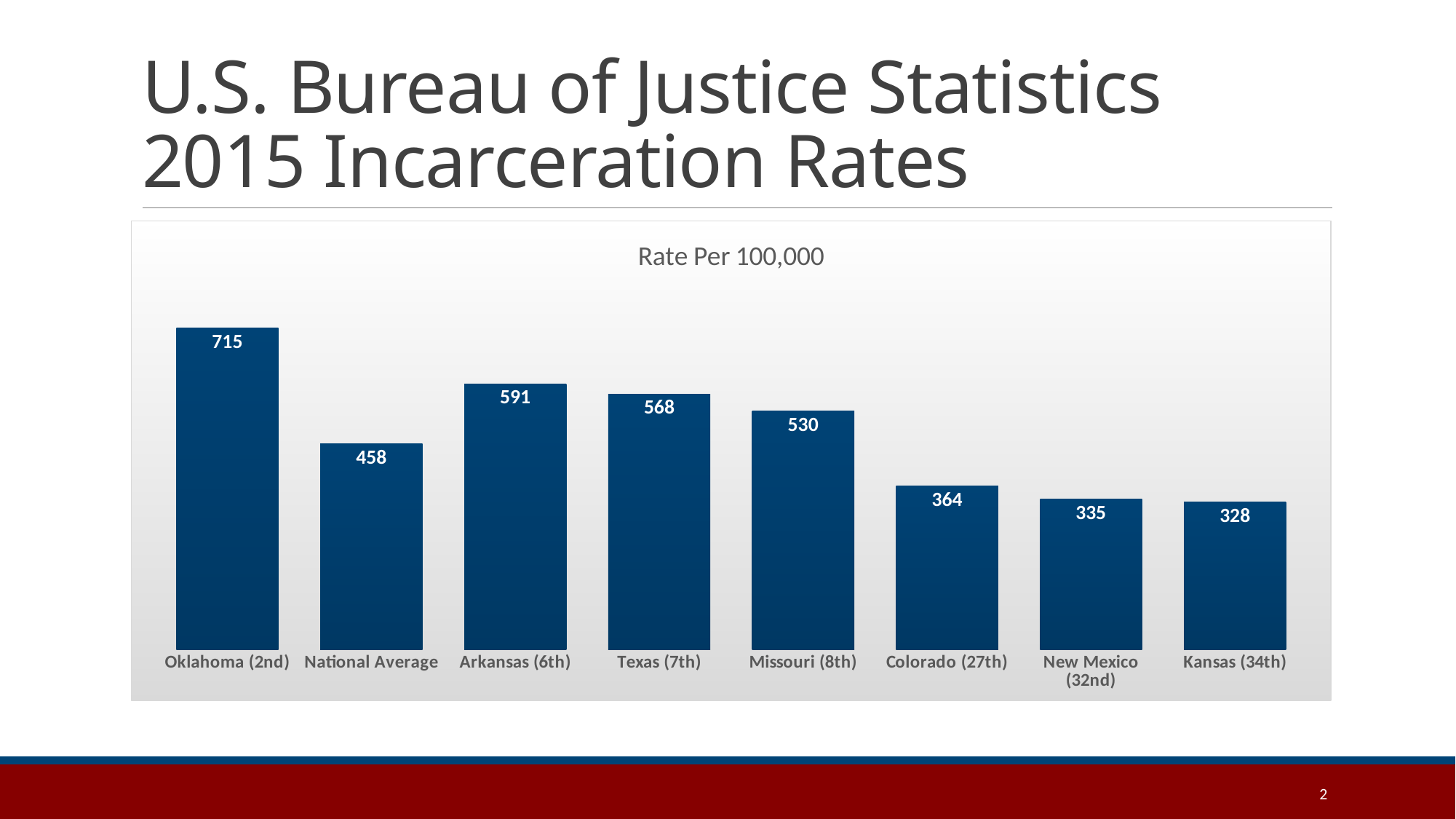
What is the rate per 100,000 for Oklahoma (2nd)? 715 What is the rate per 100,000 for New Mexico (32nd)? 335 What kind of chart is shown on the slide? Bar chart What is the difference between the rates for Oklahoma (2nd) and the National Average? 257 Which has a higher rate per 100,000, Colorado (27th) or Missouri (8th)? Missouri (8th) What is the title of the chart? Rate Per 100,000 What is the rate per 100,000 for Missouri (8th)? 530 What is the difference between the rates for Arkansas (6th) and Texas (7th)? 23 What is the rate per 100,000 for the National Average? 458 How many categories are shown in the chart? 8 Which category has the highest rate per 100,000? Oklahoma (2nd) Which category has the lowest rate per 100,000? Kansas (34th)